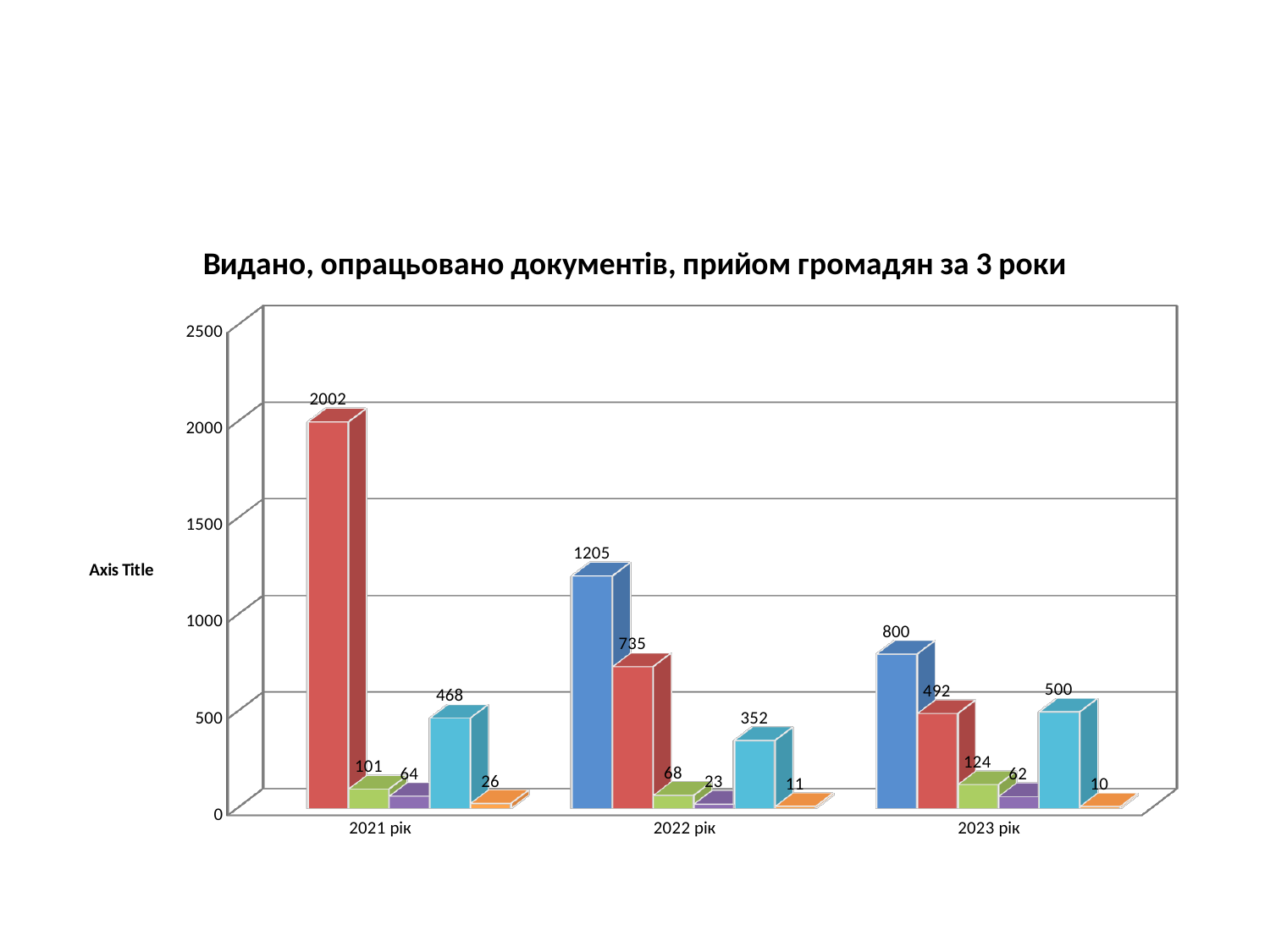
How do the red bar values change from 2021 рік to 2023 рік? They fall What is the value of the red bar for 2021 рік? 2002 What is the title of the chart? Видано, опрацьовано документів, прийом громадян за 3 роки What type of chart is shown on the slide? bar chart Which year has the highest single bar value in the chart? 2021 рік What is the difference between the red bar values for 2022 рік and 2023 рік? 243 How many year categories are shown on the x axis? 3 What is the value of the blue bar for 2022 рік? 1205 What is the value of the light blue (cyan) bar for 2023 рік? 500 Which is larger: the green bar for 2023 рік or the green bar for 2021 рік? 2023 рік What is the value of the orange bar for 2022 рік? 11 Is the blue bar for 2023 рік greater or less than 1000? less